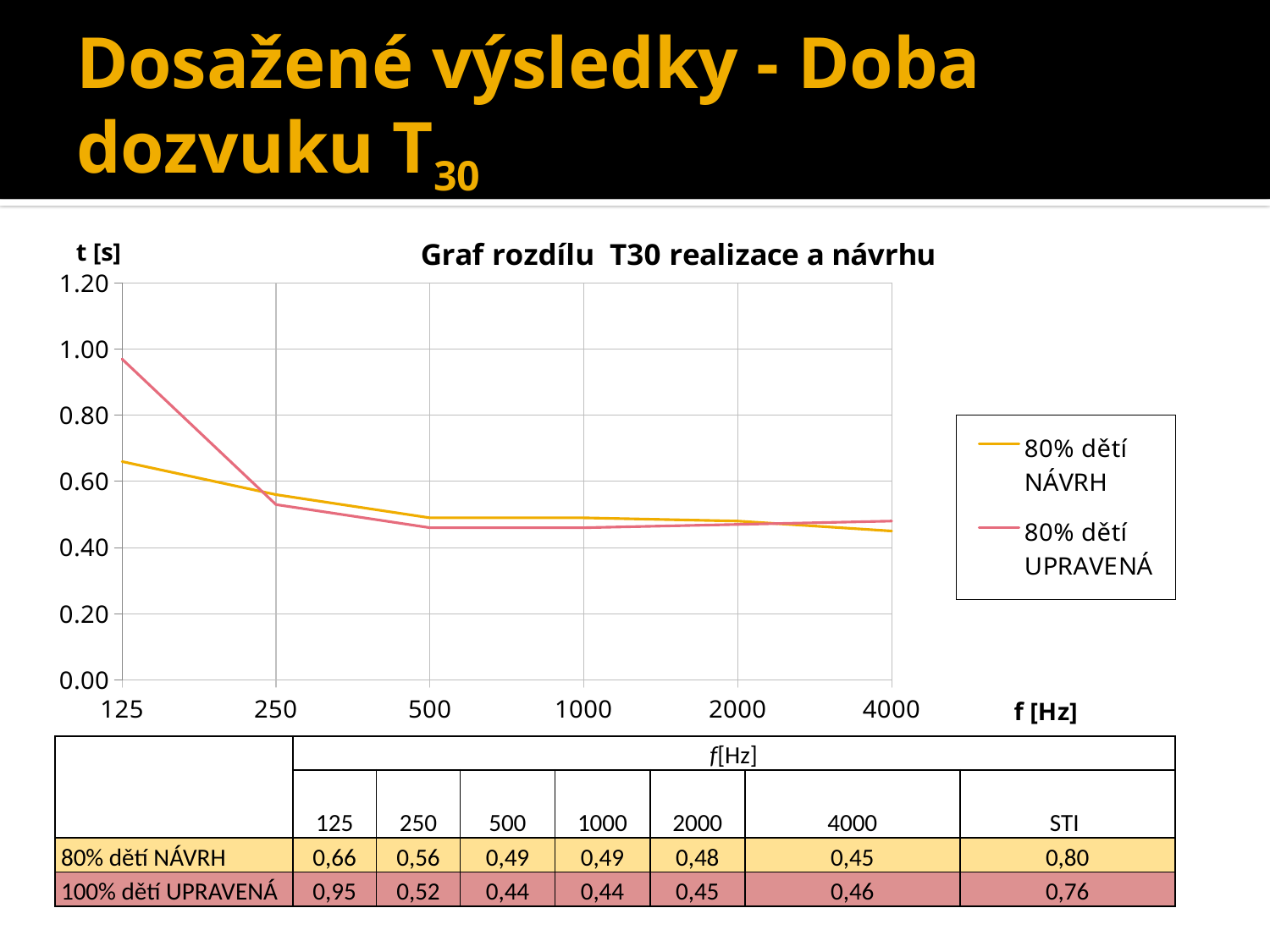
How many series does the chart legend list? 2 Is the value for 80% dětí UPRAVENÁ at 125 Hz greater or less than 0.80? greater Is the value for 80% dětí NÁVRH at 4000 Hz greater or less than 0.60? less According to the table below the chart, what is the value for 80% dětí NÁVRH at 125 Hz? 0,66 Does the 80% dětí NÁVRH line rise or fall from 125 Hz to 4000 Hz? fall At 125 Hz, which series has the higher value, 80% dětí NÁVRH or 80% dětí UPRAVENÁ? 80% dětí UPRAVENÁ What label is shown on the vertical axis of the chart? t [s] Is the value for 80% dětí NÁVRH at 125 Hz greater or less than 0.80? less What is the title of the chart? Graf rozdílu T30 realizace a návrhu What kind of chart is shown on the slide? line chart At which frequency does the 80% dětí UPRAVENÁ series reach its highest value? 125 How many frequency values are shown along the x axis of the chart? 6